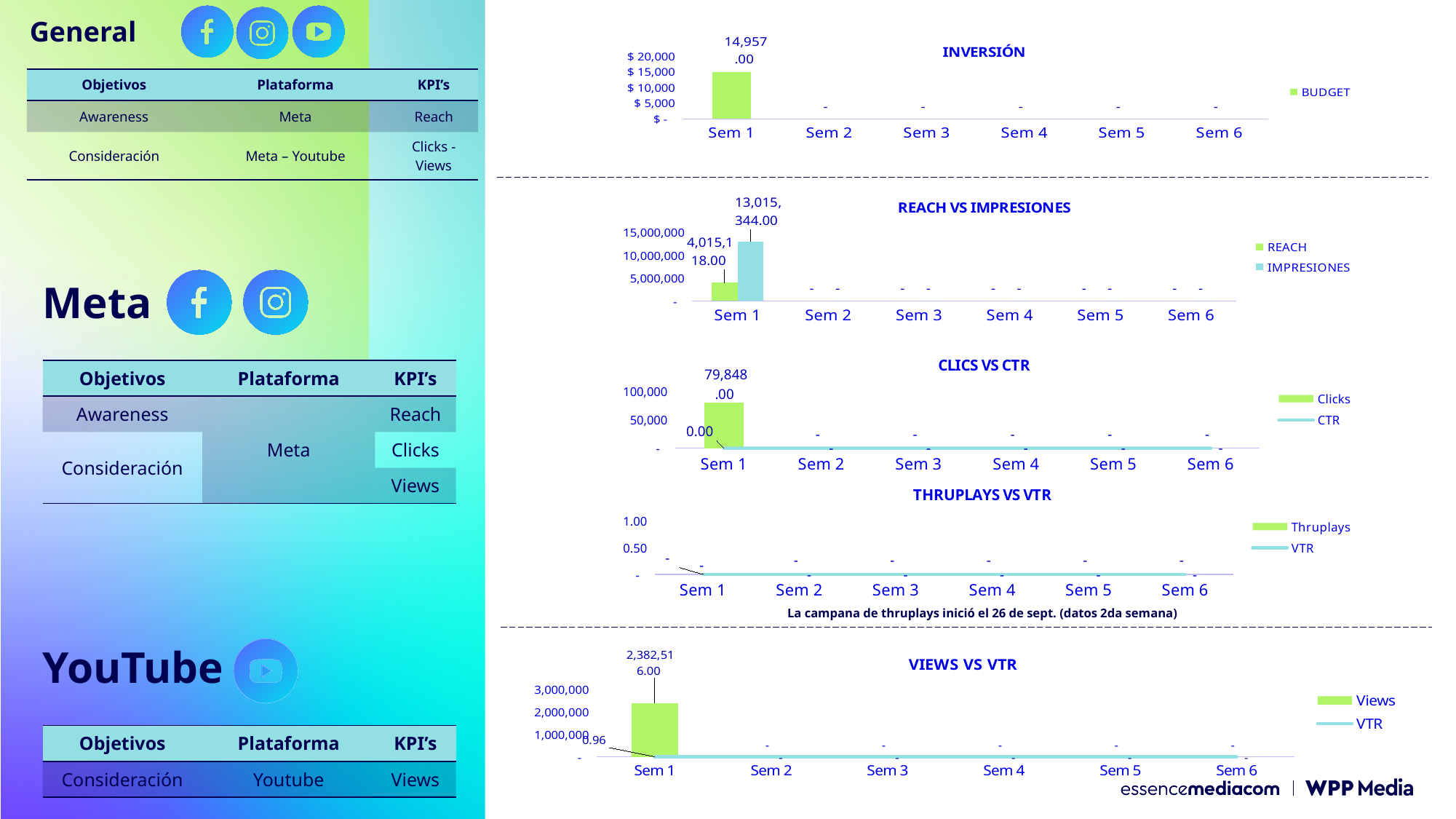
In the REACH VS IMPRESIONES chart, which is larger for Sem 1: REACH or IMPRESIONES? IMPRESIONES What kind of chart is the INVERSIÓN chart? Bar chart In the VIEWS VS VTR chart, what is the Views value for Sem 1? 2,382,516.00 In the REACH VS IMPRESIONES chart, what is the difference between IMPRESIONES and REACH for Sem 1? 9,000,226.00 In the INVERSIÓN chart, what is the BUDGET value for Sem 1? 14,957.00 In the REACH VS IMPRESIONES chart, what is the IMPRESIONES value for Sem 1? 13,015,344.00 In the CLICS VS CTR chart, what is the Clicks value for Sem 1? 79,848.00 In the REACH VS IMPRESIONES chart, how many series does the legend list? 2 In the INVERSIÓN chart, which week has the highest BUDGET value? Sem 1 In the INVERSIÓN chart, how many weeks (categories) are shown on the x axis? 6 In the VIEWS VS VTR chart, what is the VTR value for Sem 1? 0.96 In the REACH VS IMPRESIONES chart, what is the REACH value for Sem 1? 4,015,118.00